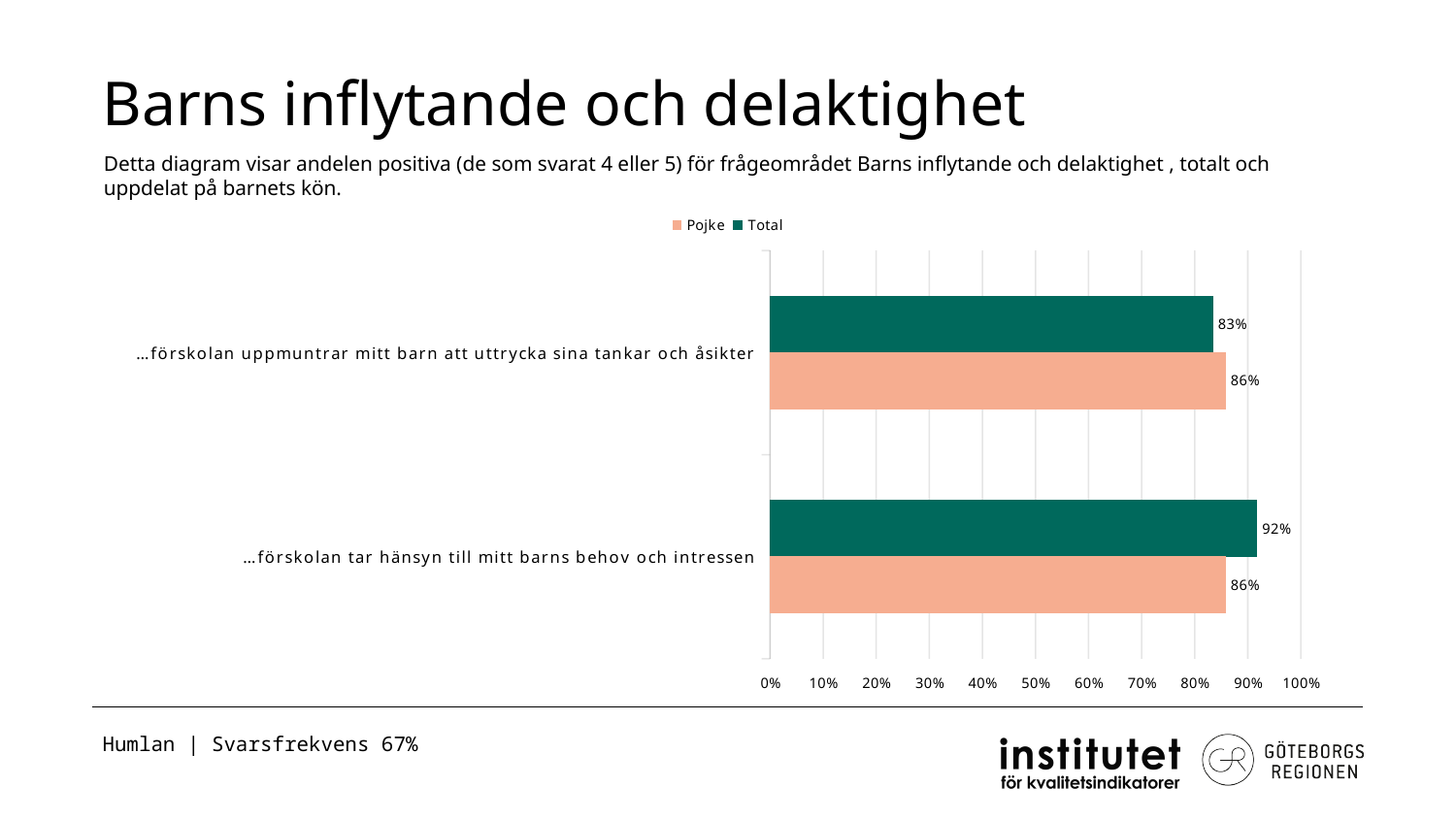
For "…förskolan uppmuntrar mitt barn att uttrycka sina tankar och åsikter", which is larger, the Pojke value or the Total value? Pojke What is the Total value for "…förskolan tar hänsyn till mitt barns behov och intressen"? 92% What is the Total value for "…förskolan uppmuntrar mitt barn att uttrycka sina tankar och åsikter"? 83% Which category has the lowest Total value? …förskolan uppmuntrar mitt barn att uttrycka sina tankar och åsikter What kind of chart is shown on the slide? Bar chart What is the Pojke value for "…förskolan tar hänsyn till mitt barns behov och intressen"? 86% How many series does the legend list? 2 What is the difference between the Total and Pojke values for "…förskolan tar hänsyn till mitt barns behov och intressen"? 6% How many categories are shown in the chart? 2 Which category has the highest Total value? …förskolan tar hänsyn till mitt barns behov och intressen Is the Total value for "…förskolan tar hänsyn till mitt barns behov och intressen" greater or less than 90%? greater What is the Pojke value for "…förskolan uppmuntrar mitt barn att uttrycka sina tankar och åsikter"? 86%